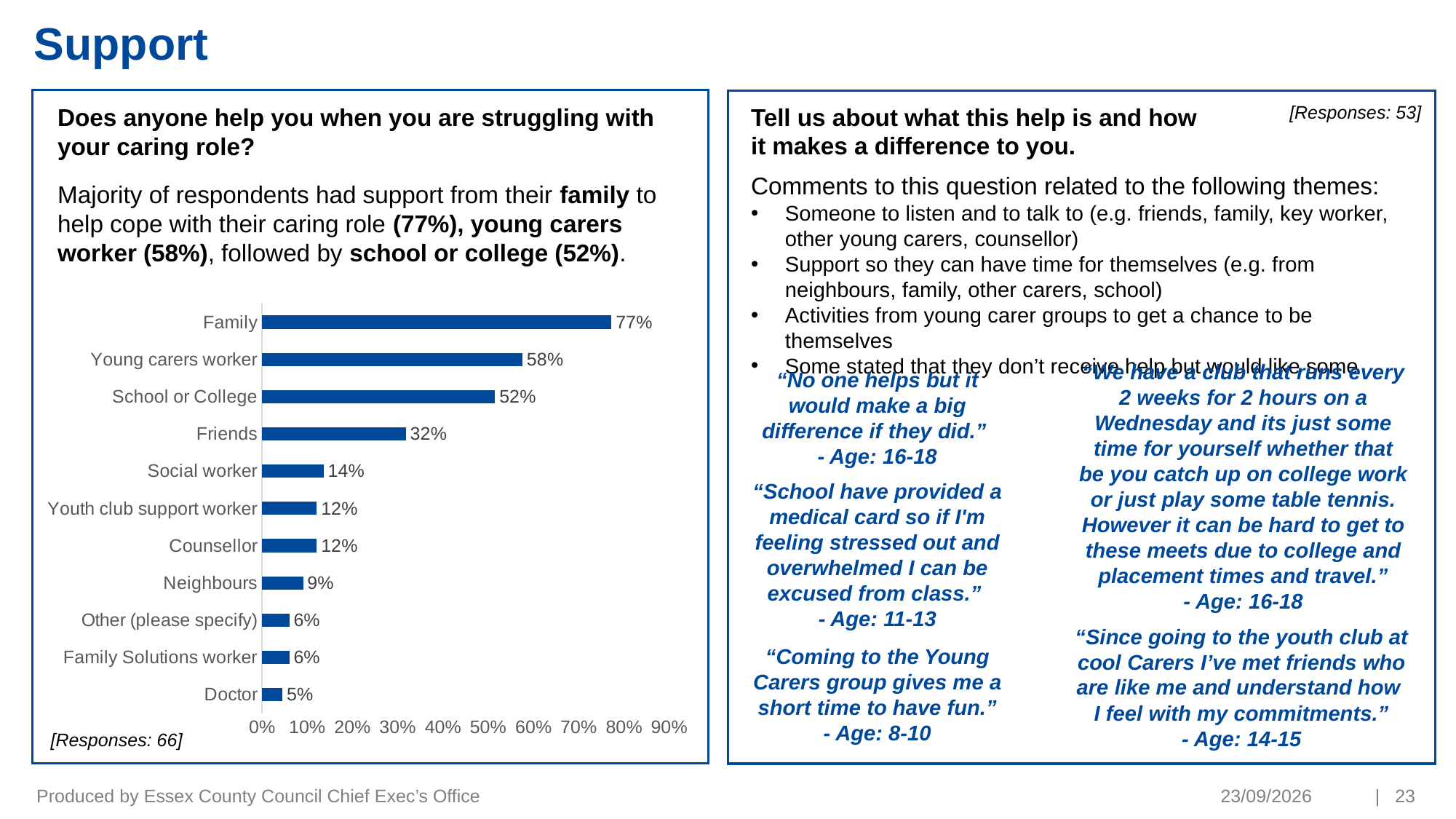
How many categories are shown in the chart? 11 Is the value for Young carers worker greater or less than 50%? greater What is the difference between the values for Family and School or College? 25% How many responses does the chart note as its base? 66 What percentage of respondents said their family helps them when struggling with their caring role? 77% Which category has the highest value in the chart? Family What type of chart is shown on the slide? Bar chart Which category has the lowest value in the chart? Doctor Which is larger, the value for Social worker or the value for Counsellor? Social worker What percentage is shown for Friends? 32% What is the value shown for Young carers worker? 58% What is the value for Neighbours? 9%